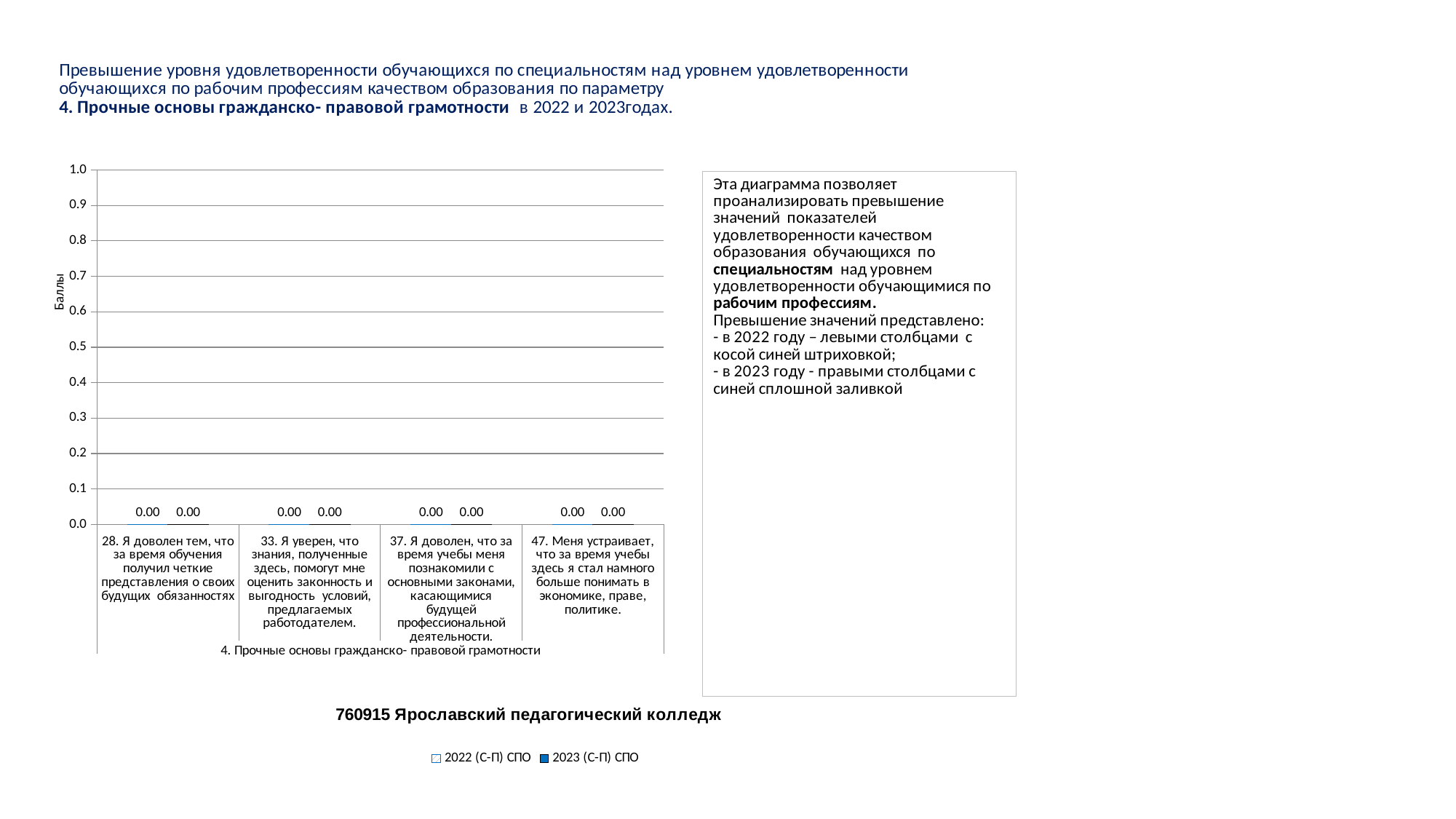
What is the value for 2023 (С-П) СПО for category 37 ("Я доволен, что за время учебы меня познакомили с основными законами, касающимися будущей профессиональной деятельности")? 0.00 What is the value for 2022 (С-П) СПО for category 28 ("Я доволен тем, что за время обучения получил четкие представления о своих будущих обязанностях")? 0.00 What is the label of the vertical axis of the chart? Баллы Is the value for 2023 (С-П) СПО for category 33 greater or less than 0.5? less What is the difference between the 2022 (С-П) СПО and 2023 (С-П) СПО values for category 28? 0.00 What is the value for 2022 (С-П) СПО for category 33 ("Я уверен, что знания, полученные здесь, помогут мне оценить законность и выгодность условий, предлагаемых работодателем")? 0.00 What are the two series names listed in the chart legend? 2022 (С-П) СПО and 2023 (С-П) СПО How many series does the chart legend list? 2 What kind of chart is shown on the slide? bar chart What is the value for 2023 (С-П) СПО for category 47 ("Меня устраивает, что за время учебы здесь я стал намного больше понимать в экономике, праве, политике")? 0.00 How many categories are shown on the x axis of the chart? 4